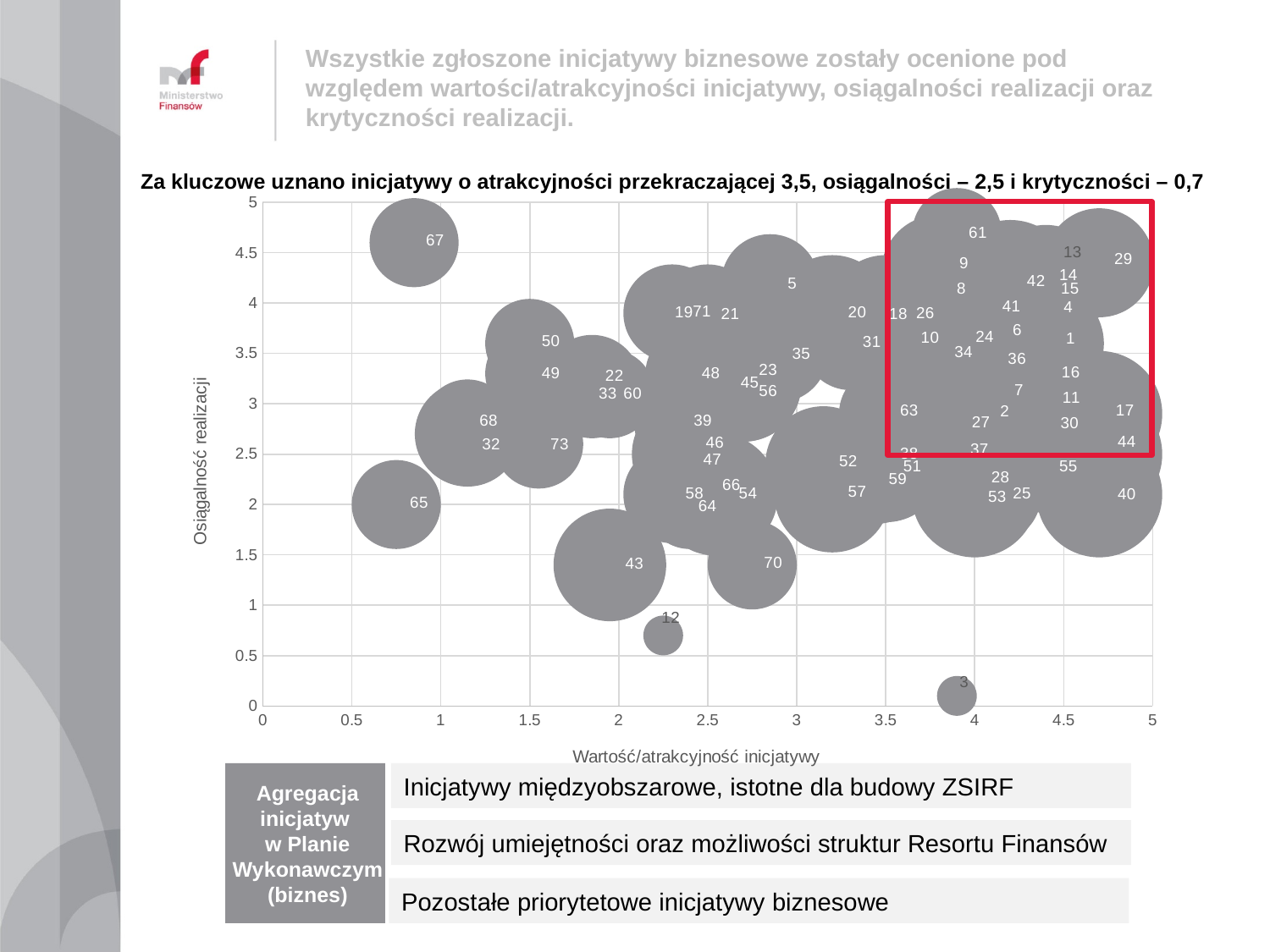
Is the horizontal-axis value (Wartość/atrakcyjność inicjatywy) for bubble 65 greater or less than 1? less What is the label of the vertical axis of the chart? Osiągalność realizacji Is the vertical-axis value (Osiągalność realizacji) for bubble 67 greater or less than 4? greater Is the vertical-axis value (Osiągalność realizacji) for bubble 3 greater or less than 0.5? less What is the label of the horizontal axis of the chart? Wartość/atrakcyjność inicjatywy Which bubble is higher on the vertical axis (Osiągalność realizacji), bubble 67 or bubble 65? 67 What kind of chart is shown on the slide? bubble chart Which bubble is higher on the vertical axis (Osiągalność realizacji), bubble 12 or bubble 3? 12 Which bubble has the lowest value on the vertical axis (Osiągalność realizacji)? 3